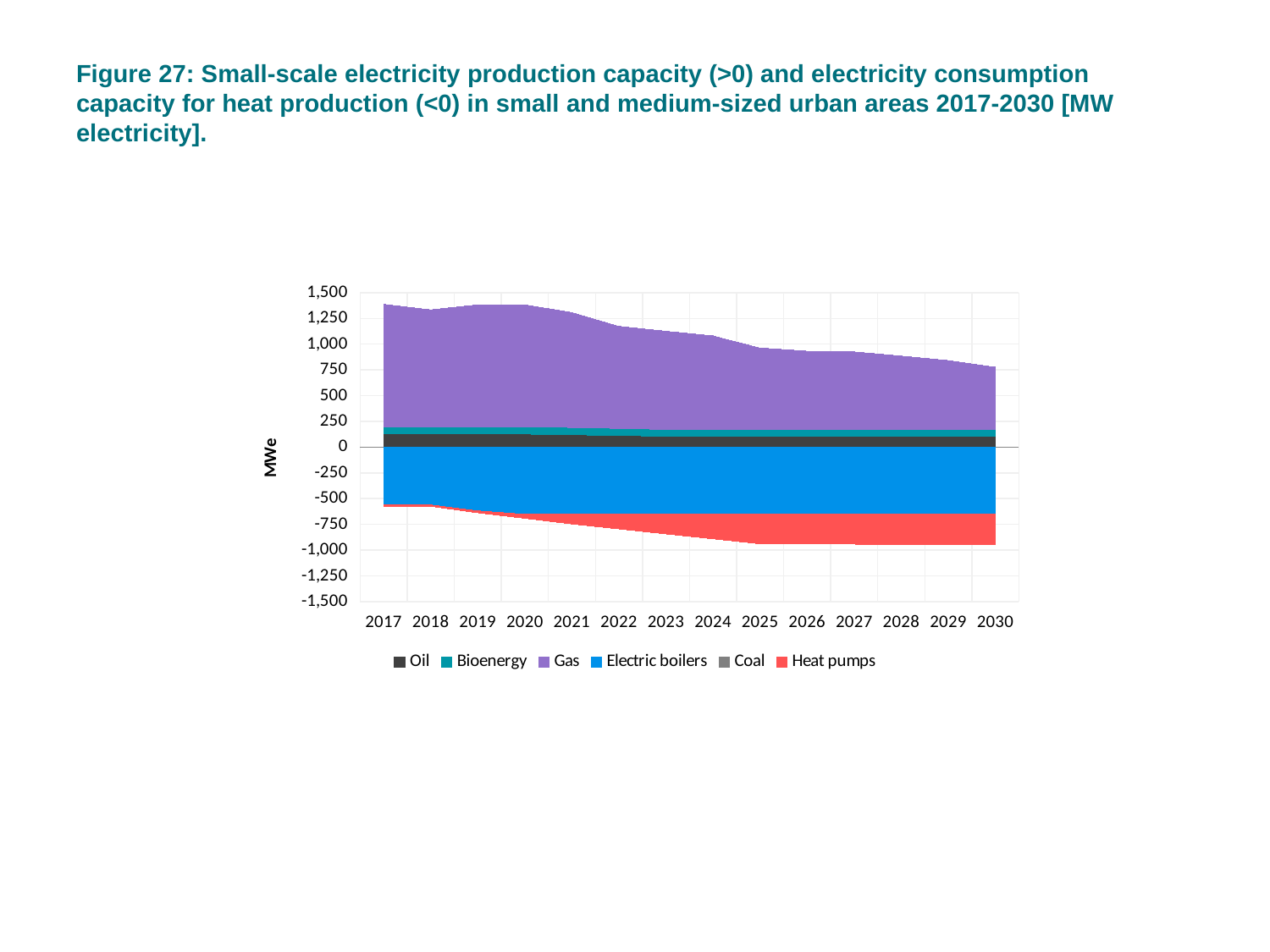
Does the total positive (production) capacity rise or fall from 2017 to 2030? Fall Which colour represents Heat pumps in the legend? Red What is the last year shown on the x axis? 2030 Which series occupies the largest area above zero? Gas What kind of chart is shown on the slide? Stacked area chart What is the label on the y axis? MWe Is the total positive production capacity in 2030 greater or less than 1,000? less What is the first year shown on the x axis? 2017 How many series does the legend list? 6 How many years are shown along the x axis? 14 Which year has the larger total positive production capacity, 2017 or 2030? 2017 Is the total positive production capacity in 2017 greater or less than 1,250? greater